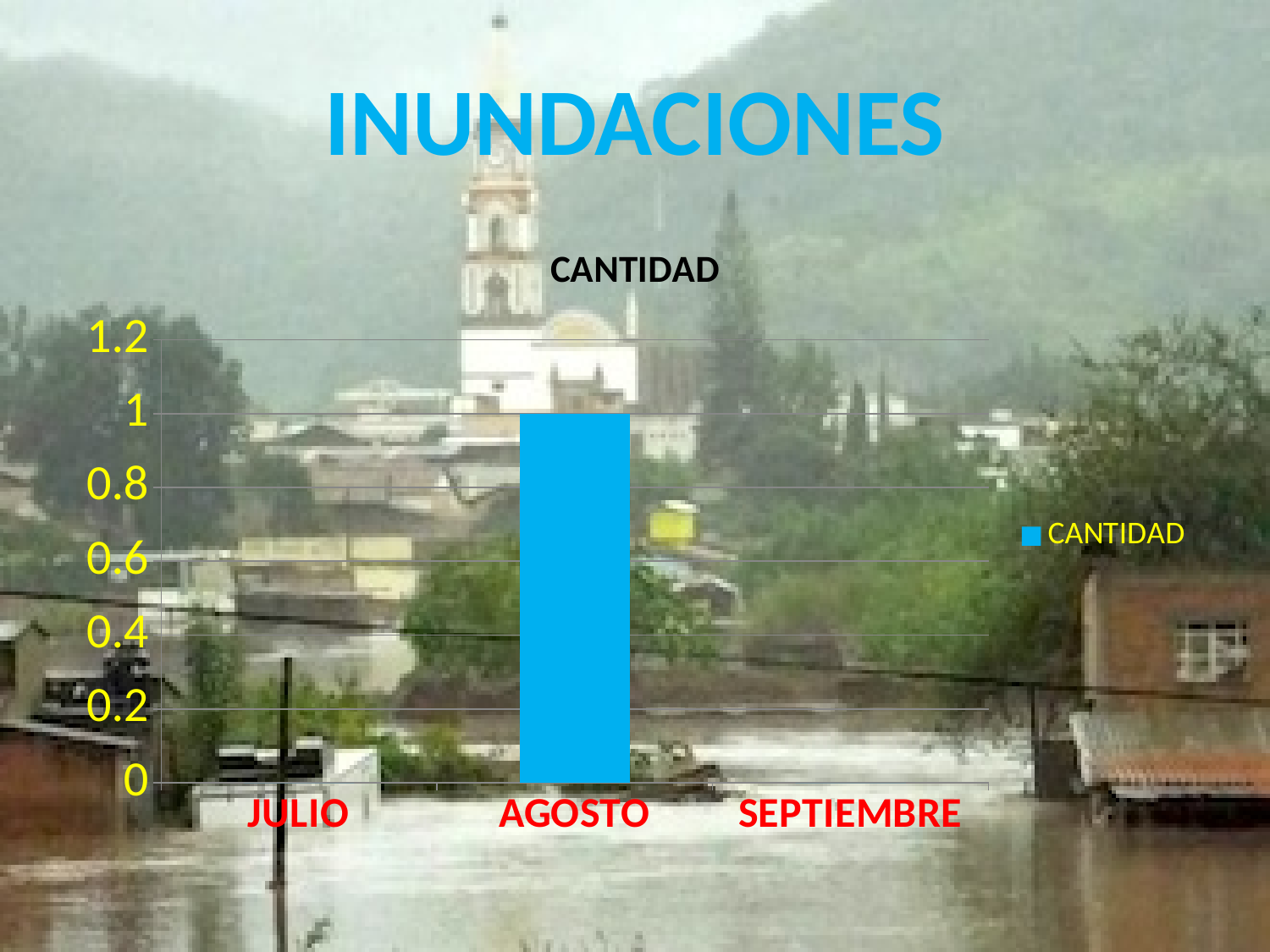
What is the highest value shown on the y axis of the chart? 1.2 Which is larger, the value for AGOSTO or the value for SEPTIEMBRE? AGOSTO Which is larger, the value for AGOSTO or the value for JULIO? AGOSTO What is the value for AGOSTO? 1 Which month has the highest value in the chart? AGOSTO Is the value for AGOSTO greater or less than 1.2? less What is the title of the chart? CANTIDAD How many categories are shown on the x axis of the chart? 3 What series name appears in the chart legend? CANTIDAD Is the value for AGOSTO greater or less than 0.8? greater How many series does the chart legend list? 1 What kind of chart is shown on the slide? bar chart